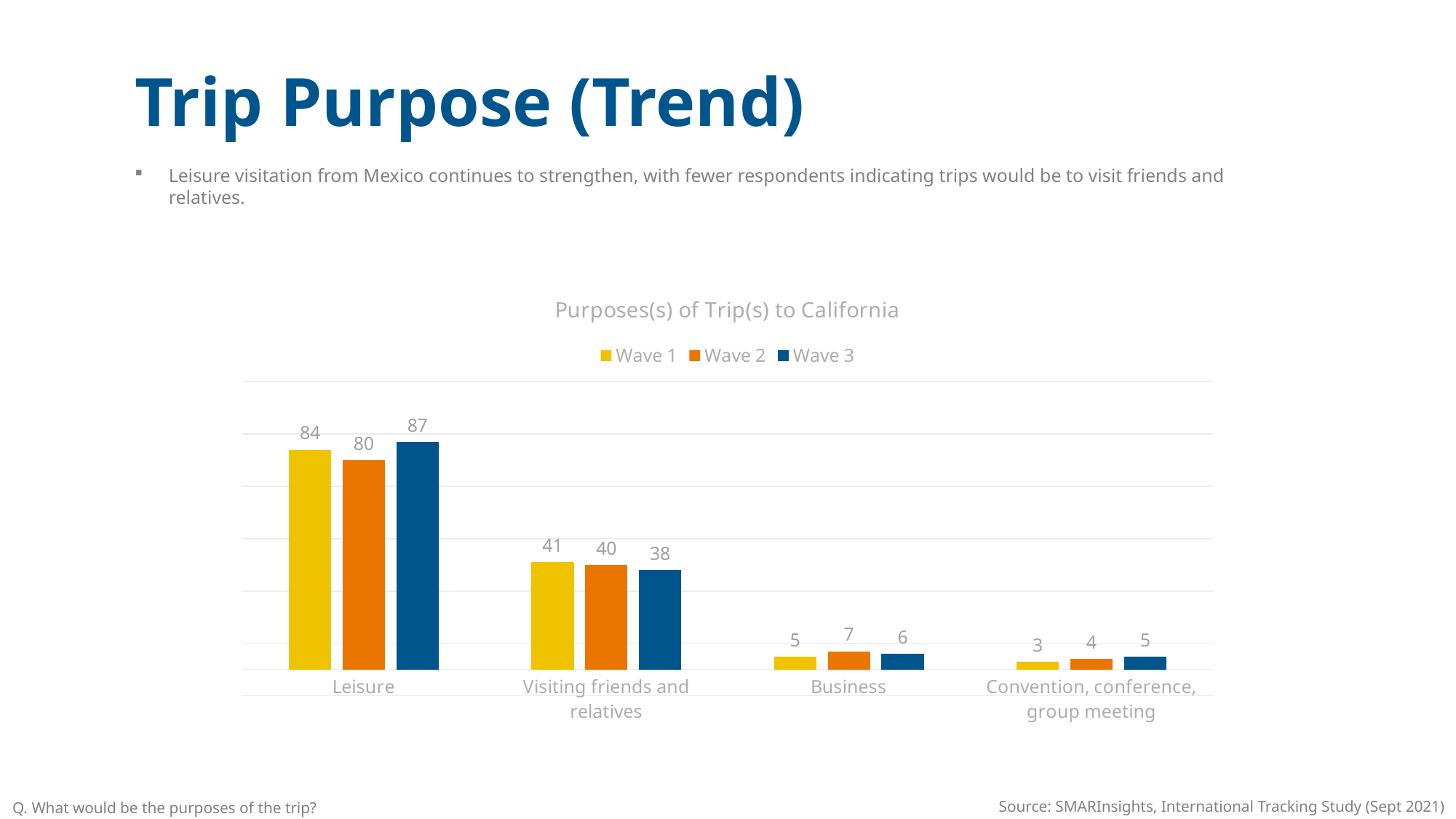
What is the Wave 2 value for Business? 7 How many series does the legend list? 3 What is the difference between the Wave 3 and Wave 2 values for Leisure? 7 What is the Wave 3 value for Convention, conference, group meeting? 5 Which category has the highest Wave 1 value? Leisure What is the title of the chart? Purposes(s) of Trip(s) to California What is the Wave 1 value for Visiting friends and relatives? 41 What is the Wave 3 value for Leisure? 87 Which category has the lowest Wave 2 value? Convention, conference, group meeting What kind of chart is shown on the slide? Bar chart How many categories are shown on the x axis? 4 For Visiting friends and relatives, which is larger: the Wave 1 value or the Wave 3 value? Wave 1